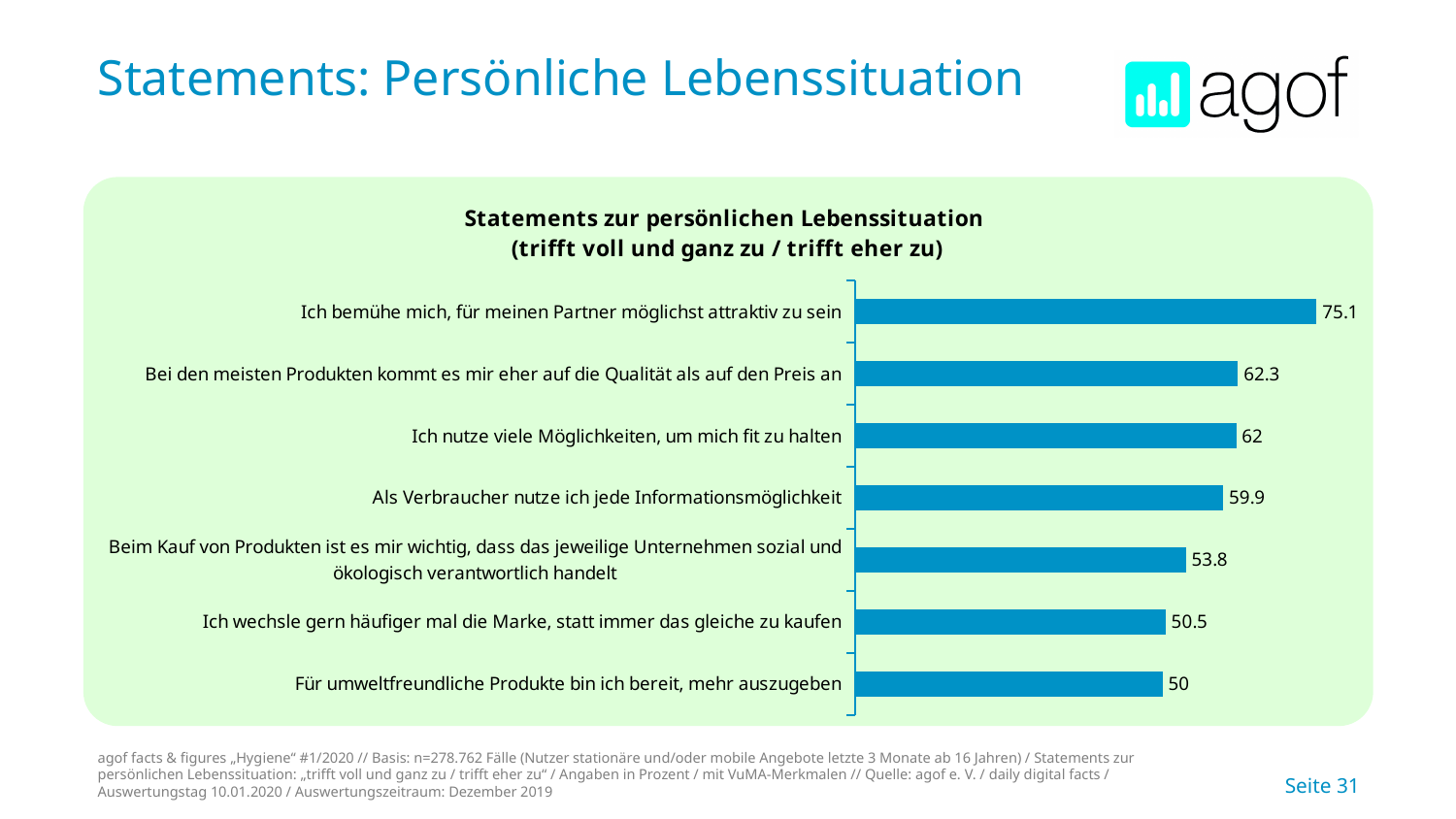
How many statements are shown in the chart? 7 What is the value for "Für umweltfreundliche Produkte bin ich bereit, mehr auszugeben"? 50 Which has a larger value: "Als Verbraucher nutze ich jede Informationsmöglichkeit" or "Beim Kauf von Produkten ist es mir wichtig, dass das jeweilige Unternehmen sozial und ökologisch verantwortlich handelt"? Als Verbraucher nutze ich jede Informationsmöglichkeit What is the value for "Ich wechsle gern häufiger mal die Marke, statt immer das gleiche zu kaufen"? 50.5 Which statement has the lowest value? Für umweltfreundliche Produkte bin ich bereit, mehr auszugeben What is the difference between the values for "Ich bemühe mich, für meinen Partner möglichst attraktiv zu sein" and "Für umweltfreundliche Produkte bin ich bereit, mehr auszugeben"? 25.1 What kind of chart is shown on the slide? Bar chart What is the value for "Als Verbraucher nutze ich jede Informationsmöglichkeit"? 59.9 What is the difference between the values for "Bei den meisten Produkten kommt es mir eher auf die Qualität als auf den Preis an" and "Ich nutze viele Möglichkeiten, um mich fit zu halten"? 0.3 Which statement has the highest value? Ich bemühe mich, für meinen Partner möglichst attraktiv zu sein What is the value for "Ich bemühe mich, für meinen Partner möglichst attraktiv zu sein"? 75.1 What is the title of the chart? Statements zur persönlichen Lebenssituation (trifft voll und ganz zu / trifft eher zu)